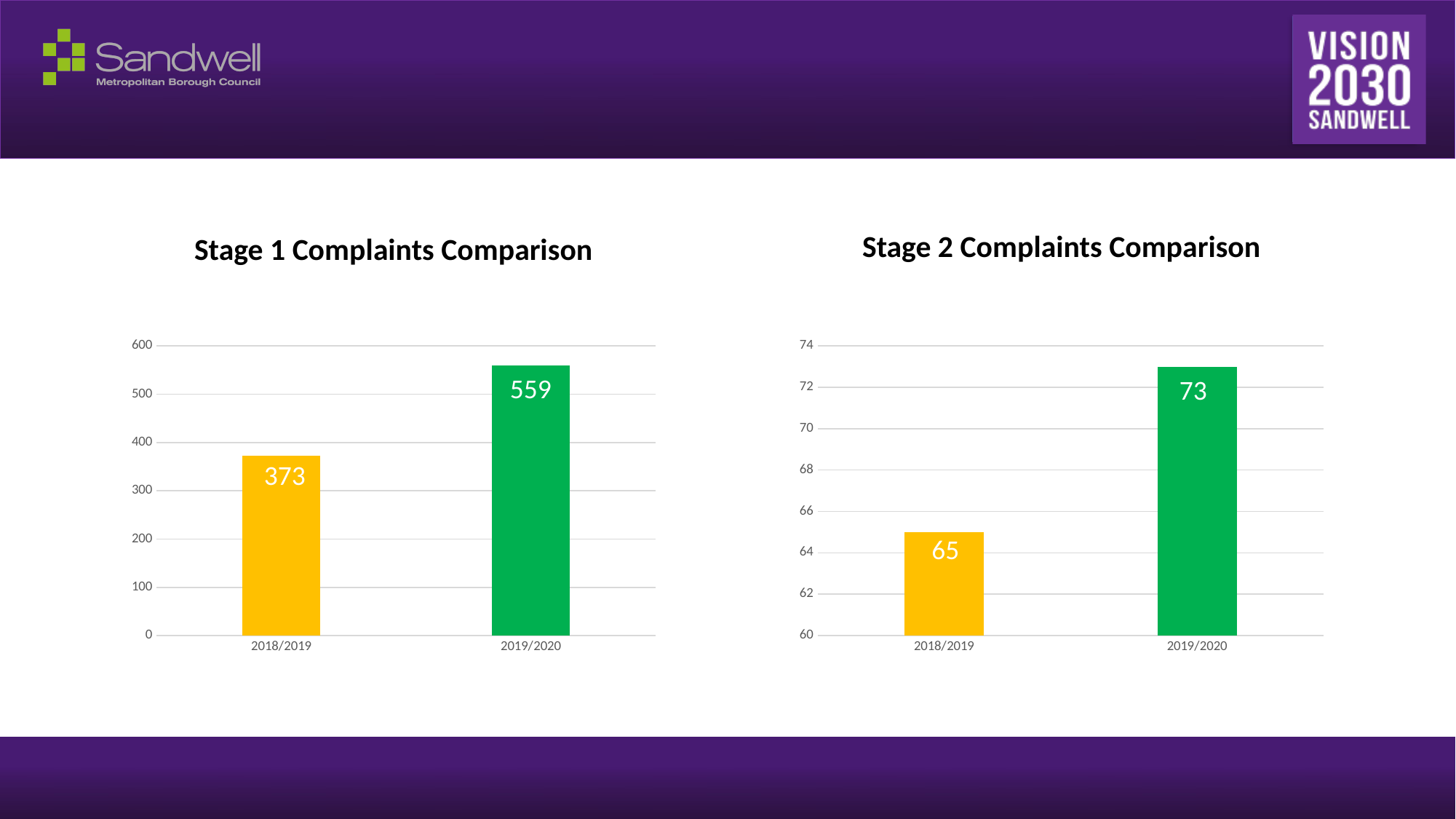
In the Stage 1 Complaints Comparison chart, what is the value for 2018/2019? 373 In the Stage 1 Complaints Comparison chart, which year has the highest value? 2019/2020 What kind of chart is the Stage 1 Complaints Comparison chart? Bar chart In the Stage 1 Complaints Comparison chart, what is the difference between the 2019/2020 and 2018/2019 values? 186 In the Stage 2 Complaints Comparison chart, which year has the lowest value? 2018/2019 In the Stage 2 Complaints Comparison chart, do the values rise or fall from 2018/2019 to 2019/2020? Rise In the Stage 2 Complaints Comparison chart, what is the difference between the 2019/2020 and 2018/2019 values? 8 How many categories are shown on the x axis of the Stage 2 Complaints Comparison chart? 2 In the Stage 1 Complaints Comparison chart, is the value for 2018/2019 greater or less than 400? less In the Stage 1 Complaints Comparison chart, what is the value for 2019/2020? 559 In the Stage 2 Complaints Comparison chart, what is the value for 2019/2020? 73 In the Stage 2 Complaints Comparison chart, what is the value for 2018/2019? 65